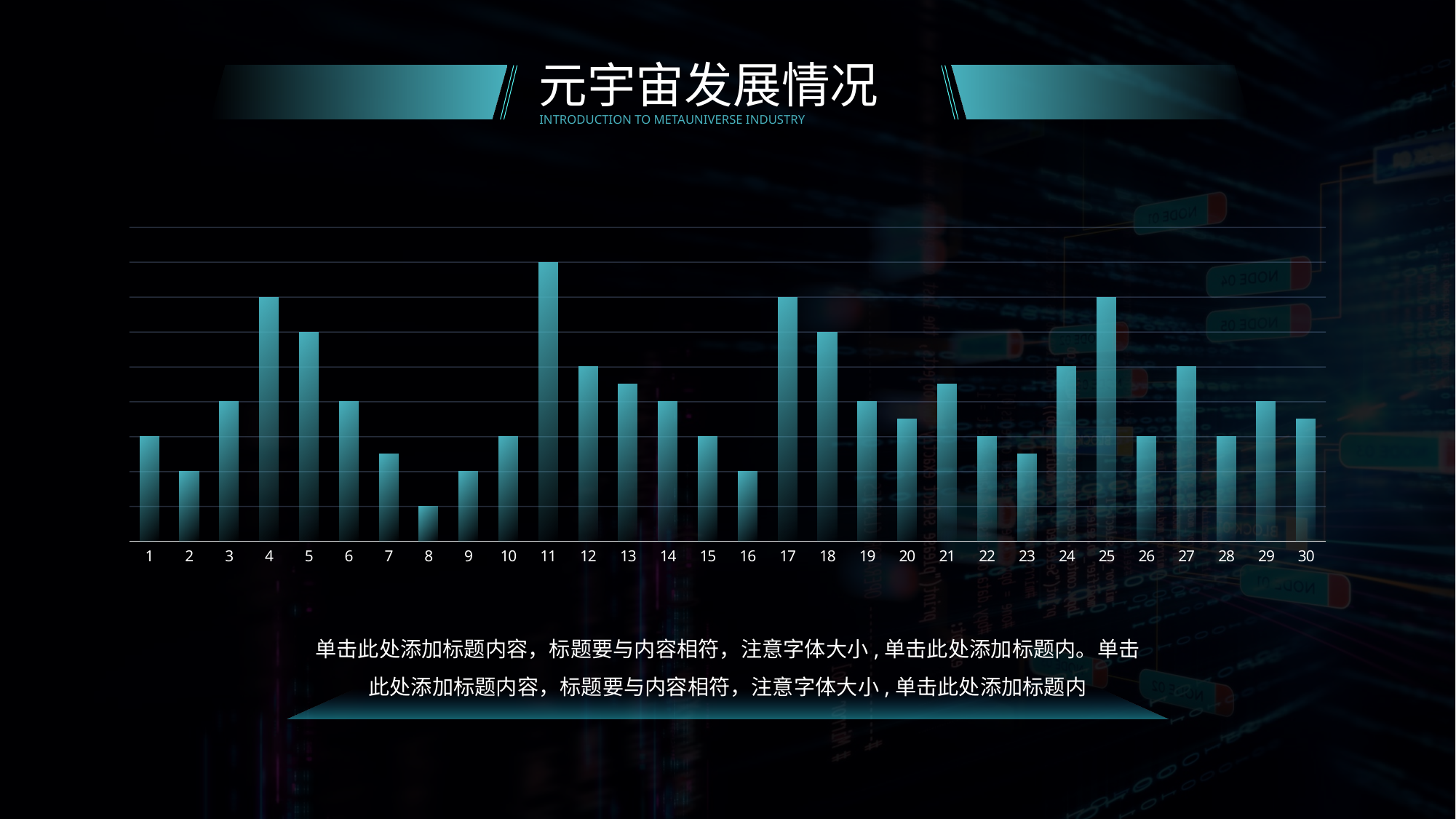
Which bar is taller, category 16 or category 17? 17 Which bar is taller, category 1 or category 2? 1 What kind of chart is shown on the slide? bar chart Which category has the shortest bar in the chart? 8 Which bar is taller, category 29 or category 30? 29 What is the title shown above the chart on the slide? 元宇宙发展情况 Which category has the tallest bar in the chart? 11 What English subtitle appears under the slide title? INTRODUCTION TO METAUNIVERSE INDUSTRY How many categories are plotted along the x axis of the chart? 30